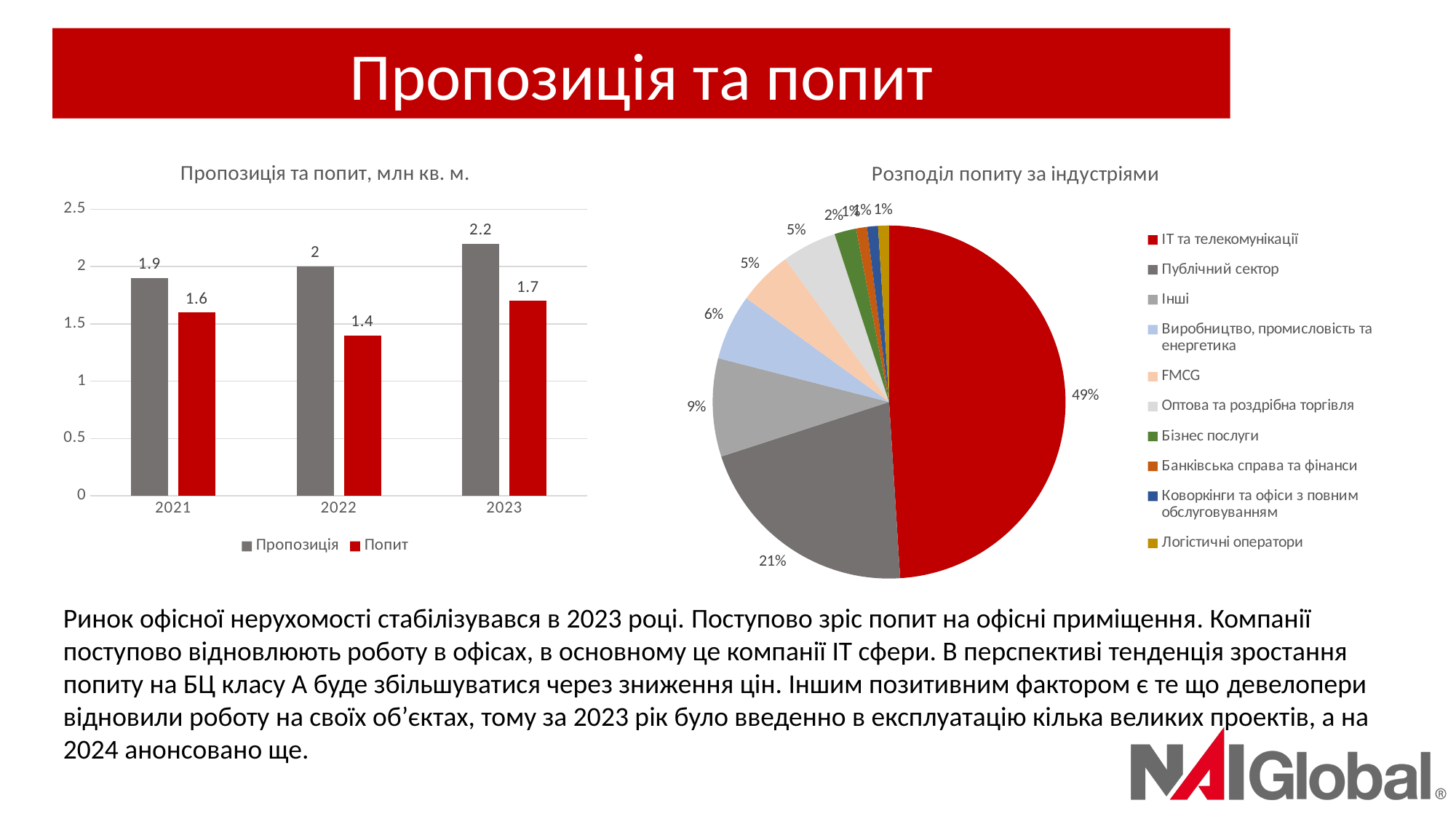
In the chart 'Пропозиція та попит, млн кв. м.', is Попит in 2023 larger or smaller than Попит in 2021? larger In the chart 'Пропозиція та попит, млн кв. м.', what is the difference between Пропозиція and Попит in 2021? 0.3 In the chart 'Пропозиція та попит, млн кв. м.', which year has the highest Пропозиція value? 2023 How many categories does the legend of the pie chart 'Розподіл попиту за індустріями' list? 10 In the pie chart 'Розподіл попиту за індустріями', what share does 'Публічний сектор' have? 21% What kind of chart is 'Пропозиція та попит, млн кв. м.'? bar chart In the chart 'Пропозиція та попит, млн кв. м.', does the Пропозиція series rise or fall from 2021 to 2023? rise In the pie chart 'Розподіл попиту за індустріями', what share does 'ІТ та телекомунікації' have? 49% In the chart 'Пропозиція та попит, млн кв. м.', which year has the lowest Попит value? 2022 How many series does the legend of the chart 'Пропозиція та попит, млн кв. м.' list? 2 In the chart 'Пропозиція та попит, млн кв. м.', what is the value of Пропозиція for 2023? 2.2 In the chart 'Пропозиція та попит, млн кв. м.', what is the value of Попит for 2022? 1.4